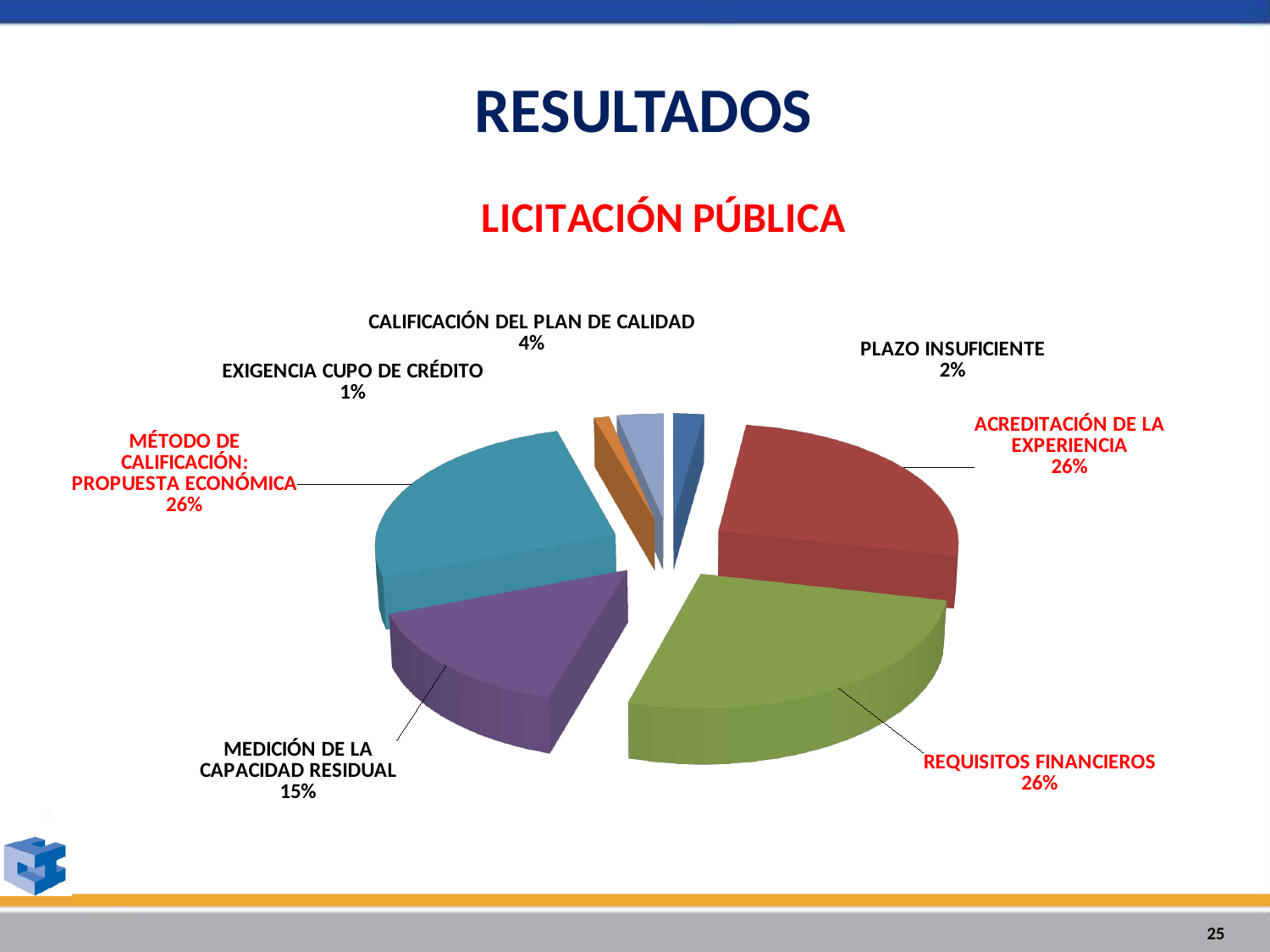
What is the difference in percentage points between CALIFICACIÓN DEL PLAN DE CALIDAD and PLAZO INSUFICIENTE? 2 percentage points What share of the pie is MEDICIÓN DE LA CAPACIDAD RESIDUAL? 15% What percentage is shown for REQUISITOS FINANCIEROS? 26% What kind of chart is shown on the slide? Pie chart Which is larger, the share for MEDICIÓN DE LA CAPACIDAD RESIDUAL or the share for PLAZO INSUFICIENTE? MEDICIÓN DE LA CAPACIDAD RESIDUAL Which category has the smallest slice of the pie? EXIGENCIA CUPO DE CRÉDITO What percentage is shown for CALIFICACIÓN DEL PLAN DE CALIDAD? 4% What is the difference in percentage points between ACREDITACIÓN DE LA EXPERIENCIA and MEDICIÓN DE LA CAPACIDAD RESIDUAL? 11 percentage points What percentage does the slice for PLAZO INSUFICIENTE represent? 2% How many slices does the pie chart have? 7 What is the red subtitle shown above the pie chart? LICITACIÓN PÚBLICA What percentage is shown for EXIGENCIA CUPO DE CRÉDITO? 1%